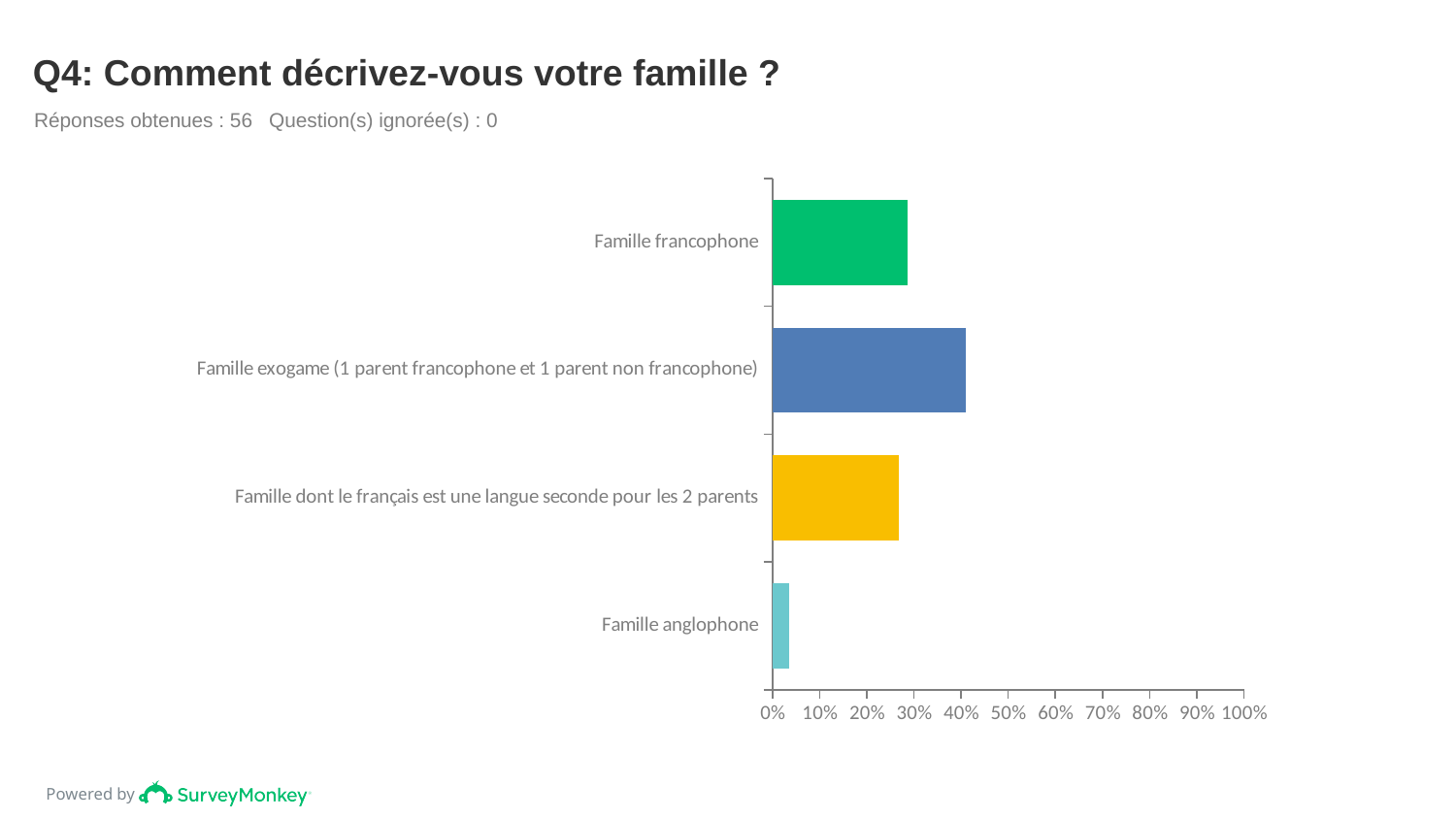
Is the value for Famille francophone greater or less than 20%? greater Is the value for Famille anglophone greater or less than 10%? less Which is larger: the value for Famille francophone or the value for Famille anglophone? Famille francophone Which family category has the highest percentage? Famille exogame (1 parent francophone et 1 parent non francophone) Which is larger: the value for Famille exogame (1 parent francophone et 1 parent non francophone) or the value for Famille francophone? Famille exogame (1 parent francophone et 1 parent non francophone) What kind of chart is shown on the slide? bar chart Which family category has the lowest percentage? Famille anglophone What is the title of the chart? Q4: Comment décrivez-vous votre famille ? Is the value for Famille dont le français est une langue seconde pour les 2 parents greater or less than 30%? less How many family categories are plotted in the chart? 4 How many responses were obtained for this question according to the slide? 56